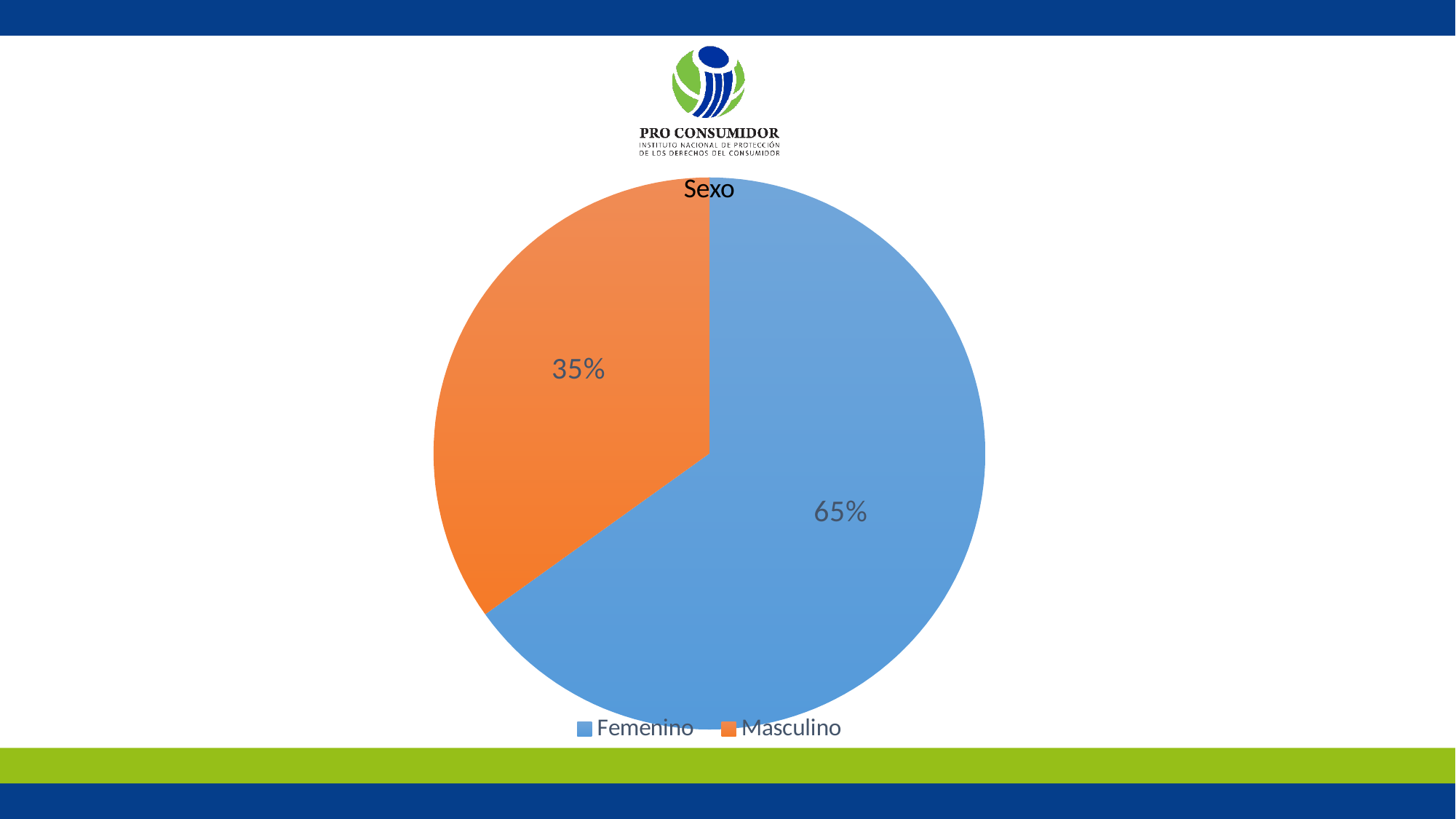
What is the title of the chart? Sexo Which is larger, the Femenino slice or the Masculino slice? Femenino What is the share of the pie taken by the blue slice? 65% What colour is the Masculino slice? orange What percentage of the pie is Femenino? 65% Which category has the smallest share of the pie? Masculino How many slices does the pie chart have? 2 What percentage of the pie is Masculino? 35% What type of chart is shown on the slide? pie chart What is the difference in percentage points between Femenino and Masculino? 30 How many entries does the legend list? 2 Which category has the largest share of the pie? Femenino